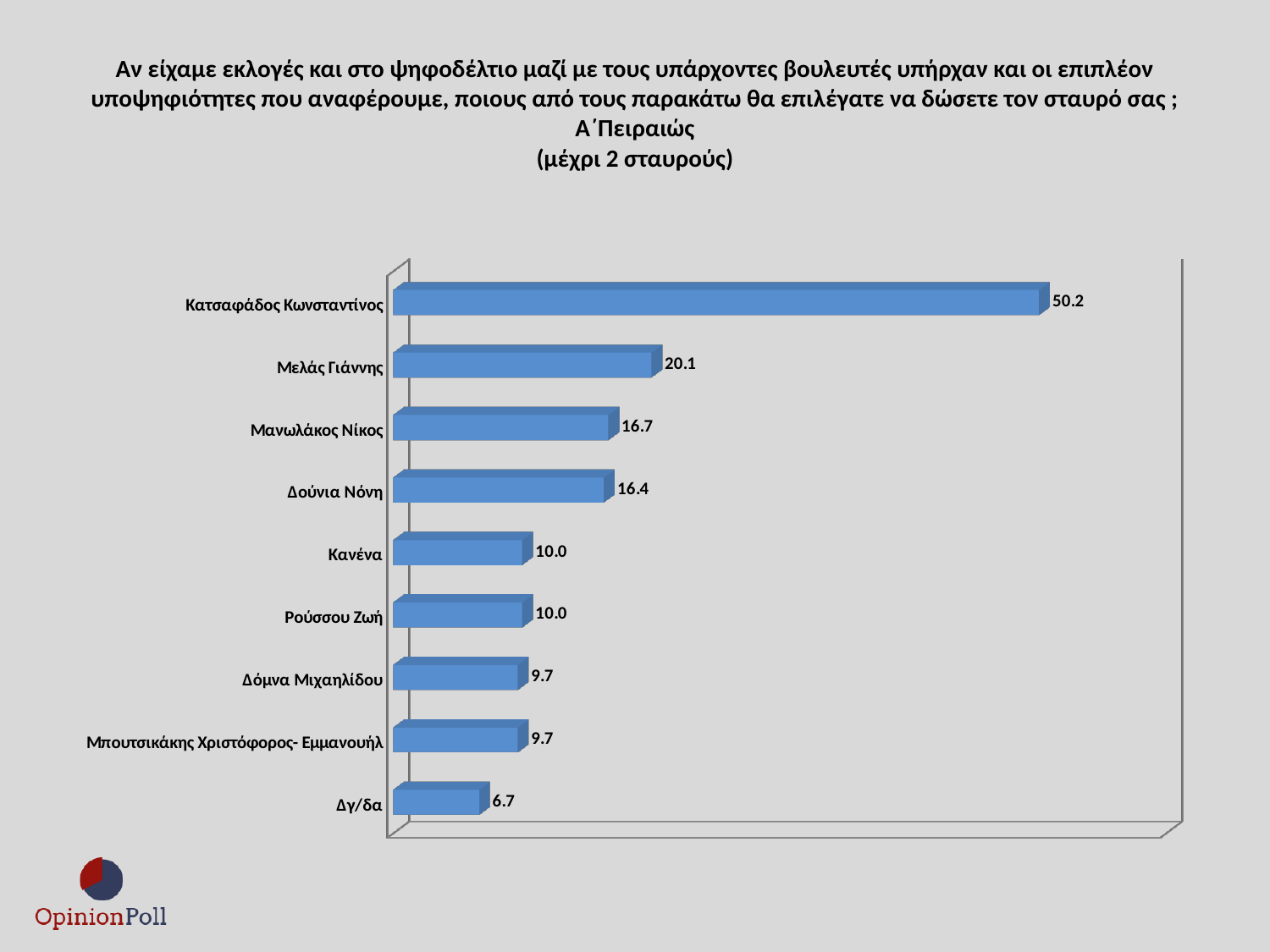
What is the value for Δγ/δα? 6.7 What is the value for Κατσαφάδος Κωνσταντίνος? 50.2 Which two categories both have a value of 9.7? Δόμνα Μιχαηλίδου and Μπουτσικάκης Χριστόφορος- Εμμανουήλ Which category has the highest value? Κατσαφάδος Κωνσταντίνος Which category has the lowest value? Δγ/δα What is the value for Μελάς Γιάννης? 20.1 What is the value for Δούνια Νόνη? 16.4 What is the difference between the values for Κατσαφάδος Κωνσταντίνος and Μελάς Γιάννης? 30.1 Which is larger, the value for Μελάς Γιάννης or the value for Μανωλάκος Νίκος? Μελάς Γιάννης What is the difference between the values for Μανωλάκος Νίκος and Δούνια Νόνη? 0.3 What kind of chart is shown on the slide? Bar chart How many categories are shown in the chart? 9